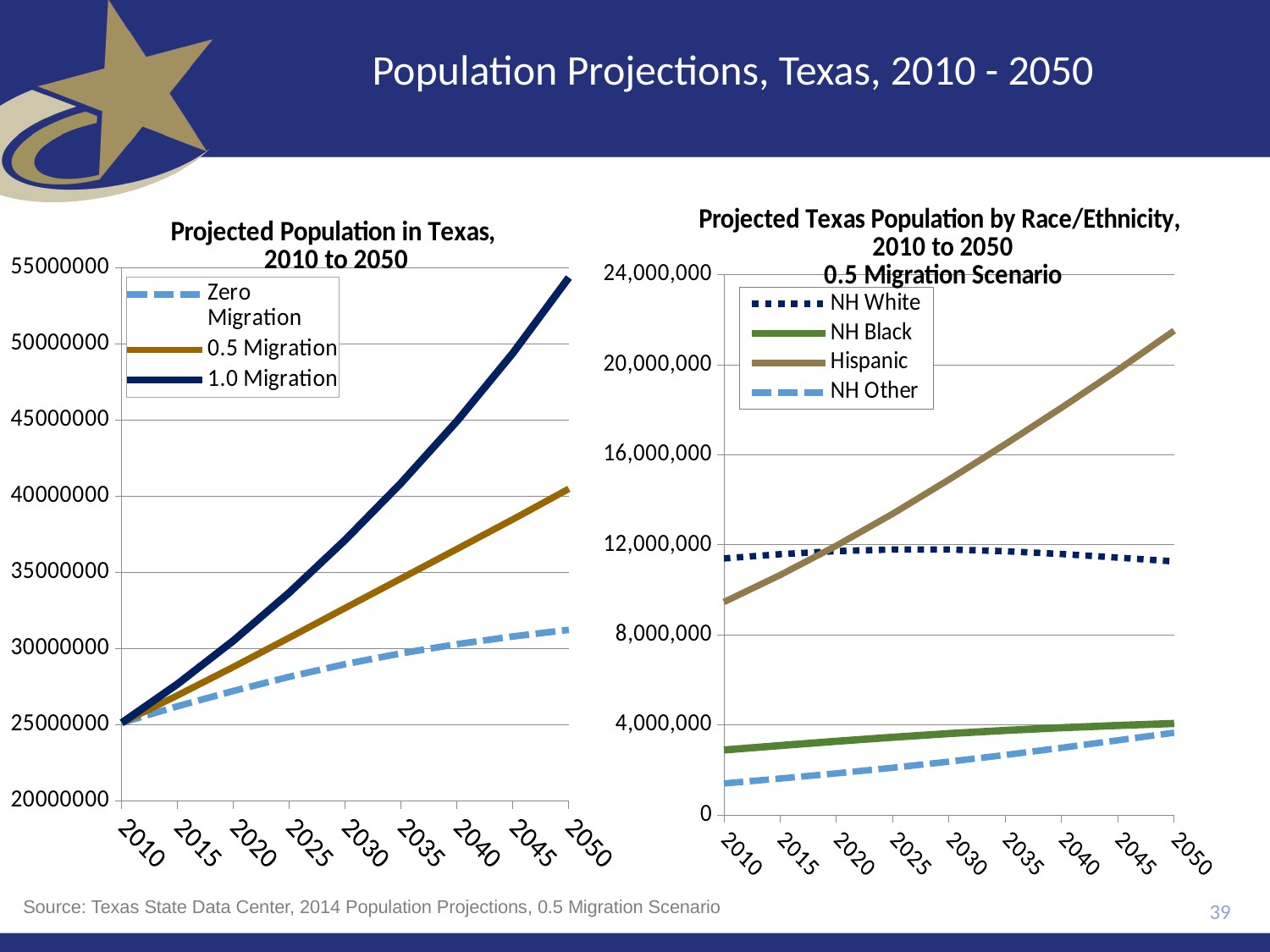
In the right chart, 'Projected Texas Population by Race/Ethnicity', which group has the highest projected population in 2050? Hispanic In the right chart, 'Projected Texas Population by Race/Ethnicity', which group has the lowest projected population in 2010? NH Other In the right chart, 'Projected Texas Population by Race/Ethnicity', does the NH Other line rise or fall from 2010 to 2050? Rise How many series does the legend of the right chart, 'Projected Texas Population by Race/Ethnicity', list? 4 In the left chart, 'Projected Population in Texas', which series has the highest value in 2050? 1.0 Migration How many series does the legend of the left chart, 'Projected Population in Texas, 2010 to 2050', list? 3 In the left chart, 'Projected Population in Texas', is the Zero Migration value in 2050 greater or less than 35000000? less In the right chart, 'Projected Texas Population by Race/Ethnicity', which is larger in 2010: NH White or Hispanic? NH White How many years are labelled on the x axis of the right chart, 'Projected Texas Population by Race/Ethnicity'? 9 In the right chart, 'Projected Texas Population by Race/Ethnicity', is the Hispanic value in 2050 greater or less than 20,000,000? greater What kind of chart is the 'Projected Population in Texas, 2010 to 2050' chart on the left? Line chart In the left chart, 'Projected Population in Texas', is the 1.0 Migration value in 2050 greater or less than 50000000? greater